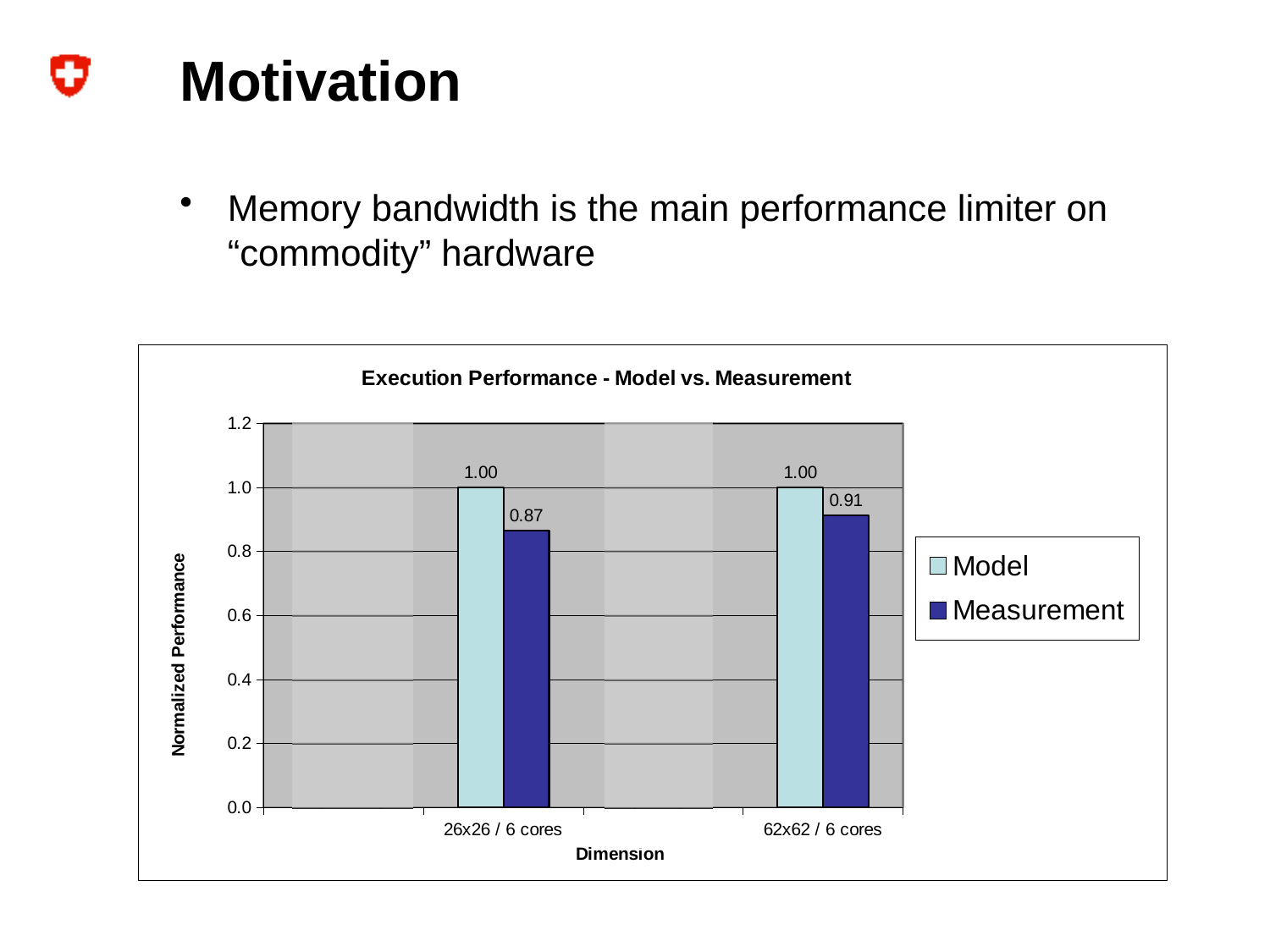
What is the Model value for 26x26 / 6 cores? 1.00 What kind of chart is shown on the slide? bar chart What is the title of the chart? Execution Performance - Model vs. Measurement Is the Measurement value for 26x26 / 6 cores greater or less than 1.0? less What is the difference between the Measurement values for 62x62 / 6 cores and 26x26 / 6 cores? 0.04 What is the difference between the Model and Measurement values for 26x26 / 6 cores? 0.13 Which dimension has the lowest Measurement value? 26x26 / 6 cores How many dimension categories are shown on the x axis? 2 Which is larger for 62x62 / 6 cores, the Model value or the Measurement value? Model How many series does the legend list? 2 What is the Measurement value for 26x26 / 6 cores? 0.87 What is the Measurement value for 62x62 / 6 cores? 0.91